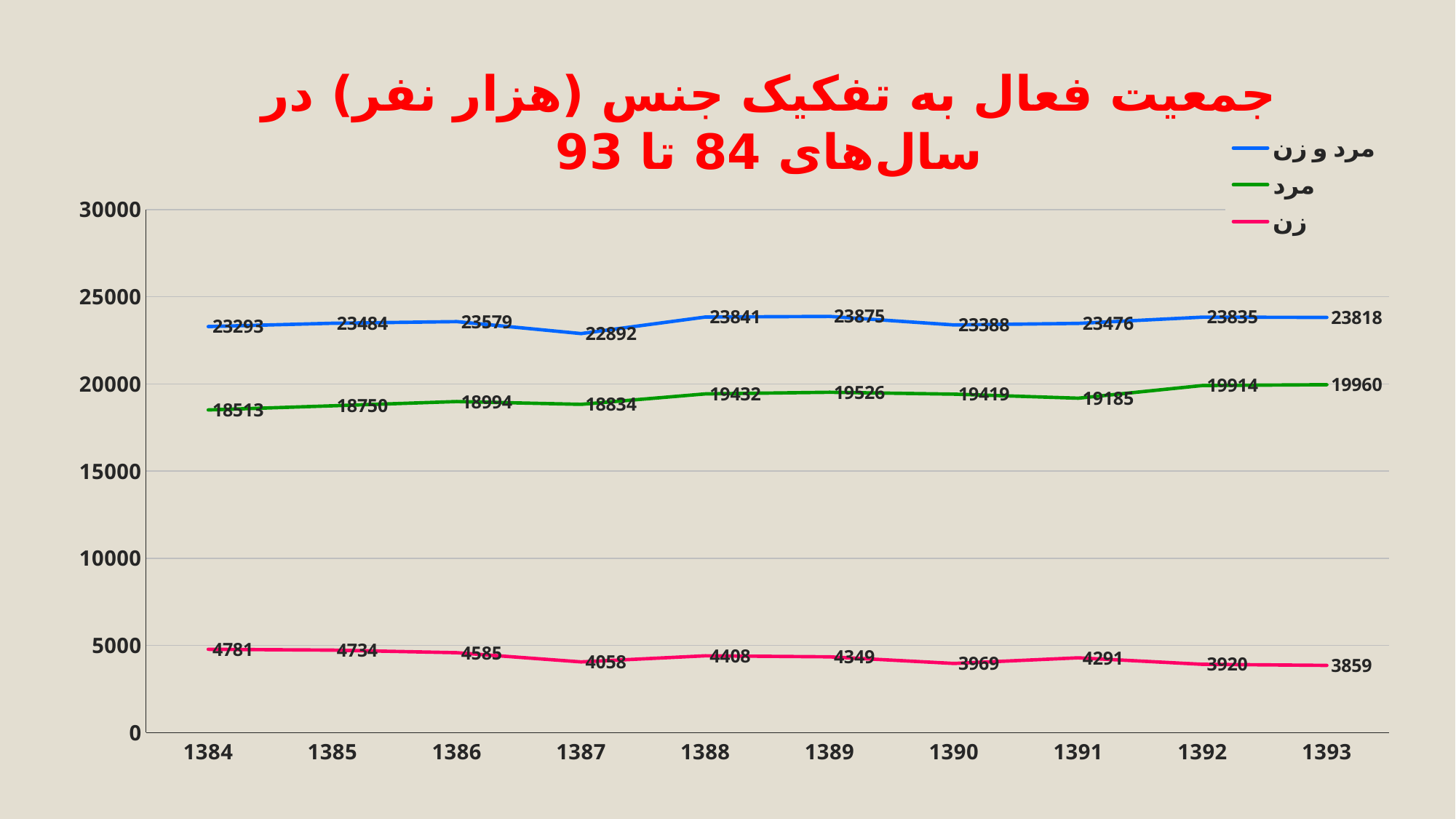
What is the difference between the مرد value in 1393 and the مرد value in 1384? 1447 What is the value of the زن (pink) series in 1387? 4058 How many years are shown on the x axis? 10 Which colour is used for the مرد series in the legend? green In which year does the زن (pink) series reach its highest value? 1384 What type of chart is shown on the slide? line chart In which year does the مرد و زن (blue) series reach its lowest value? 1387 What is the value of the مرد (green) series in 1393? 19960 How many series does the legend list? 3 What is the value of the مرد و زن (blue) series in 1389? 23875 Does the زن (pink) series generally rise or fall from 1384 to 1393? fall Which is larger: the زن value in 1388 or the زن value in 1391? 1388